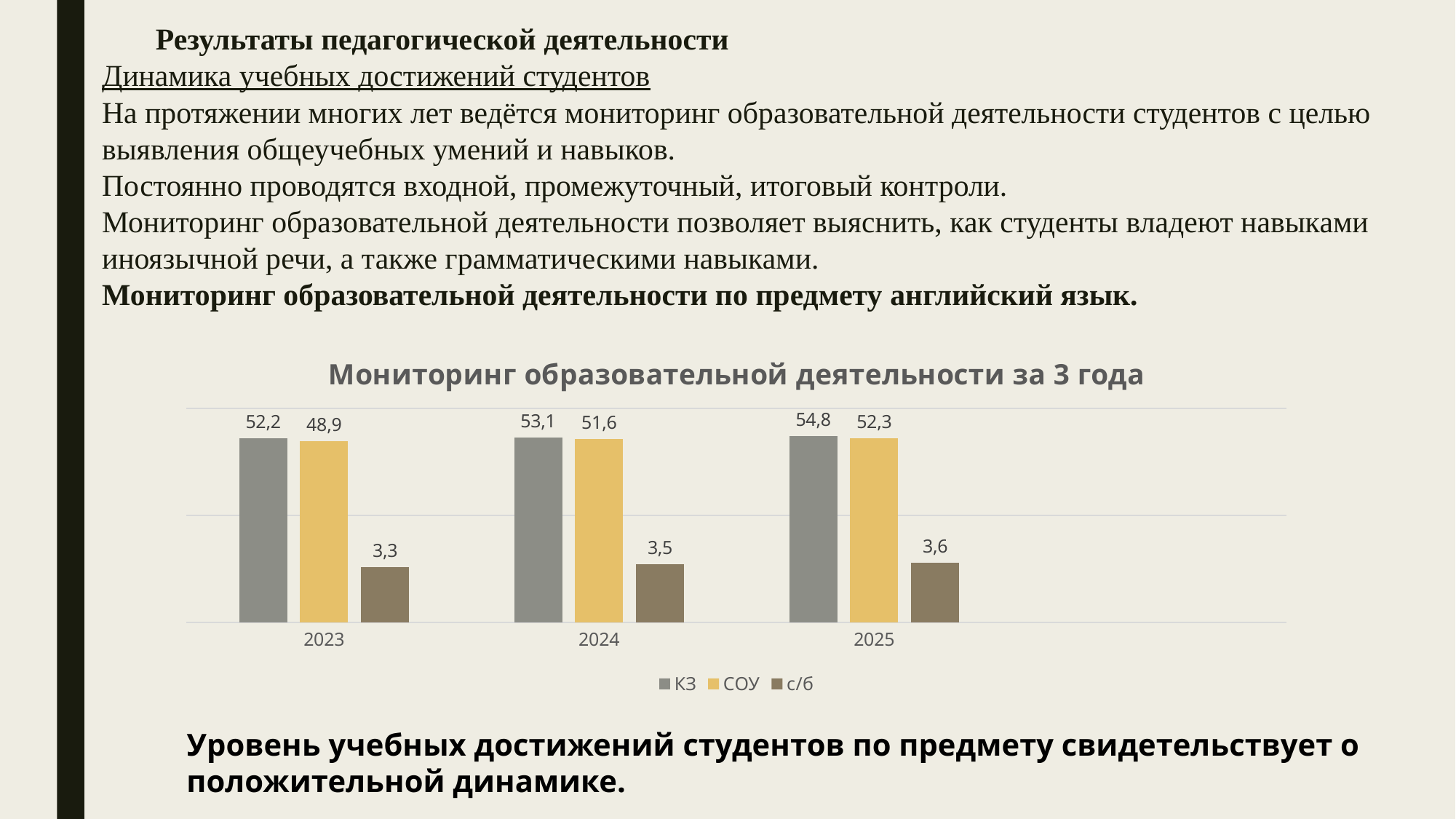
What is the value of СОУ for 2024? 51,6 How many years are shown on the x axis? 3 Do the с/б values rise or fall from 2023 to 2025? rise How many series does the legend list? 3 Which is larger in 2024: the КЗ value or the СОУ value? КЗ What is the value of КЗ for 2023? 52,2 In which year is the КЗ value highest? 2025 What is the value of с/б for 2025? 3,6 What kind of chart is shown on the slide? bar chart In which year is the СОУ value lowest? 2023 What is the difference between the КЗ value in 2025 and the КЗ value in 2023? 2,6 What is the title of the chart? Мониторинг образовательной деятельности за 3 года